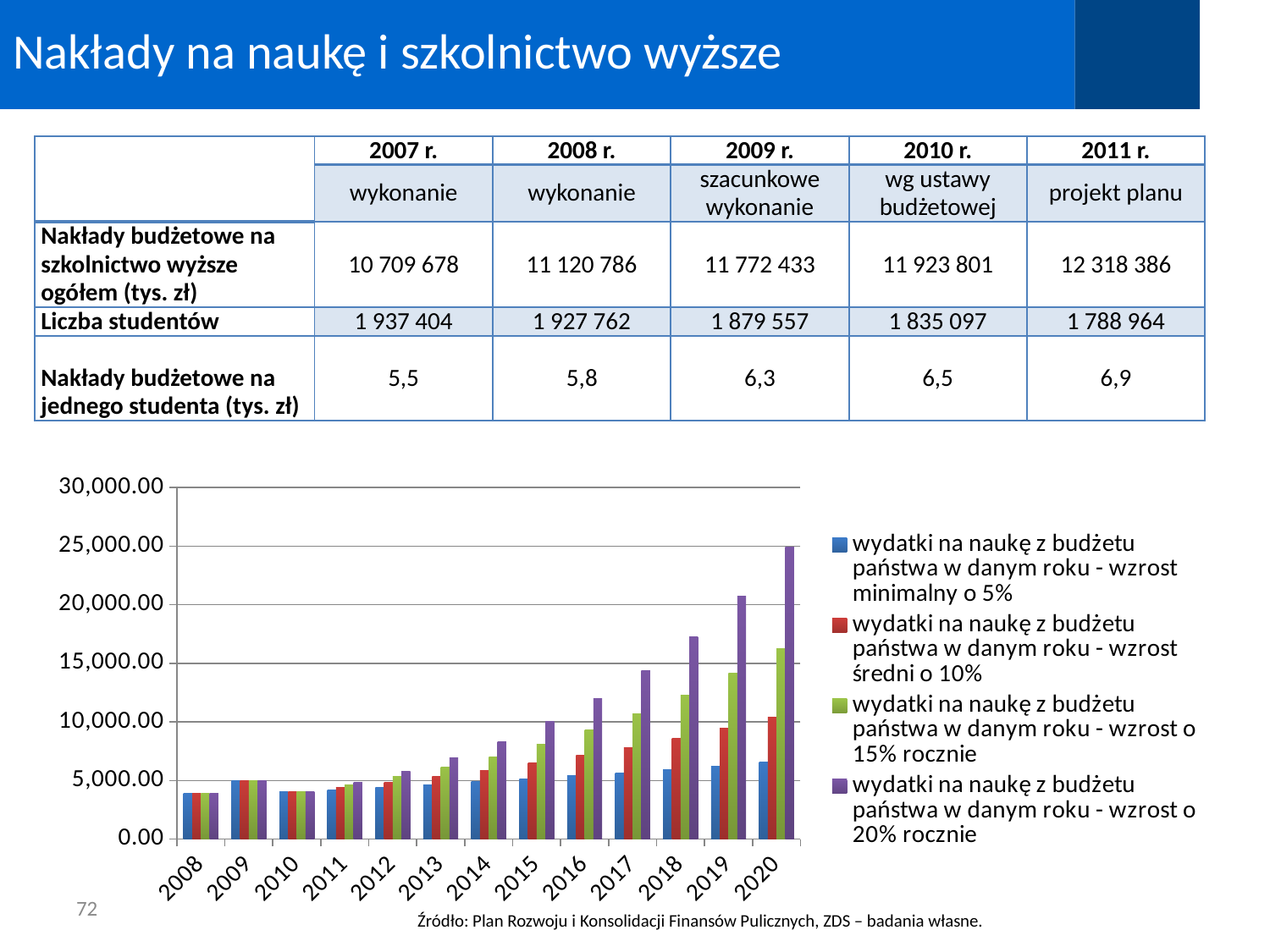
Which year is the first category on the chart's x axis? 2008 In which year is the bar for 'wzrost o 20% rocznie' the highest? 2020 Which series has the tallest bar in 2020? wydatki na naukę z budżetu państwa w danym roku - wzrost o 20% rocznie Is the 2008 value for the 'wzrost minimalny o 5%' series greater or less than 5,000.00? less How many years are shown along the x axis of the chart? 13 Is the 2020 value for the 'wzrost o 20% rocznie' series greater or less than 20,000.00? greater Is the 2018 value for the 'wzrost o 20% rocznie' series greater or less than 15,000.00? greater How many series does the chart's legend list? 4 Do the values for the 'wzrost o 20% rocznie' series rise or fall from 2010 to 2020? rise Which year is the last category on the chart's x axis? 2020 What kind of chart is shown on the slide? bar chart